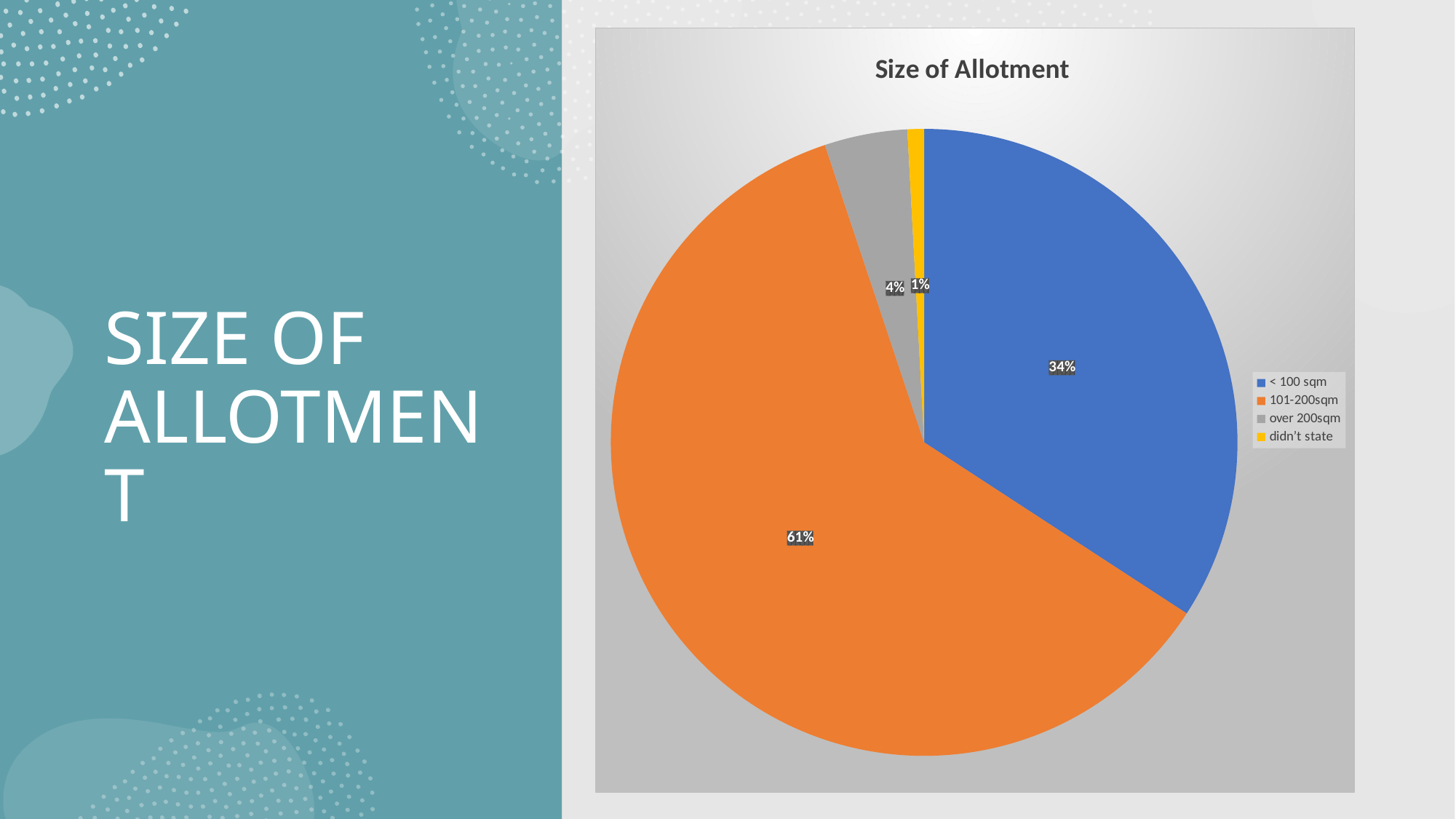
Which is larger, the '< 100 sqm' slice or the 'over 200sqm' slice? < 100 sqm What share of the pie does the 'didn't state' slice represent? 1% What kind of chart is shown on the slide? pie chart Which category has the smallest slice of the pie? didn't state What is the difference in percentage points between the '101-200sqm' slice and the '< 100 sqm' slice? 27% What colour is the '101-200sqm' slice? orange How many categories does the pie chart show? 4 What is the title of the chart? Size of Allotment What share of the pie does the 'over 200sqm' slice represent? 4% What share of the pie does the '< 100 sqm' slice represent? 34% Which category has the largest slice of the pie? 101-200sqm